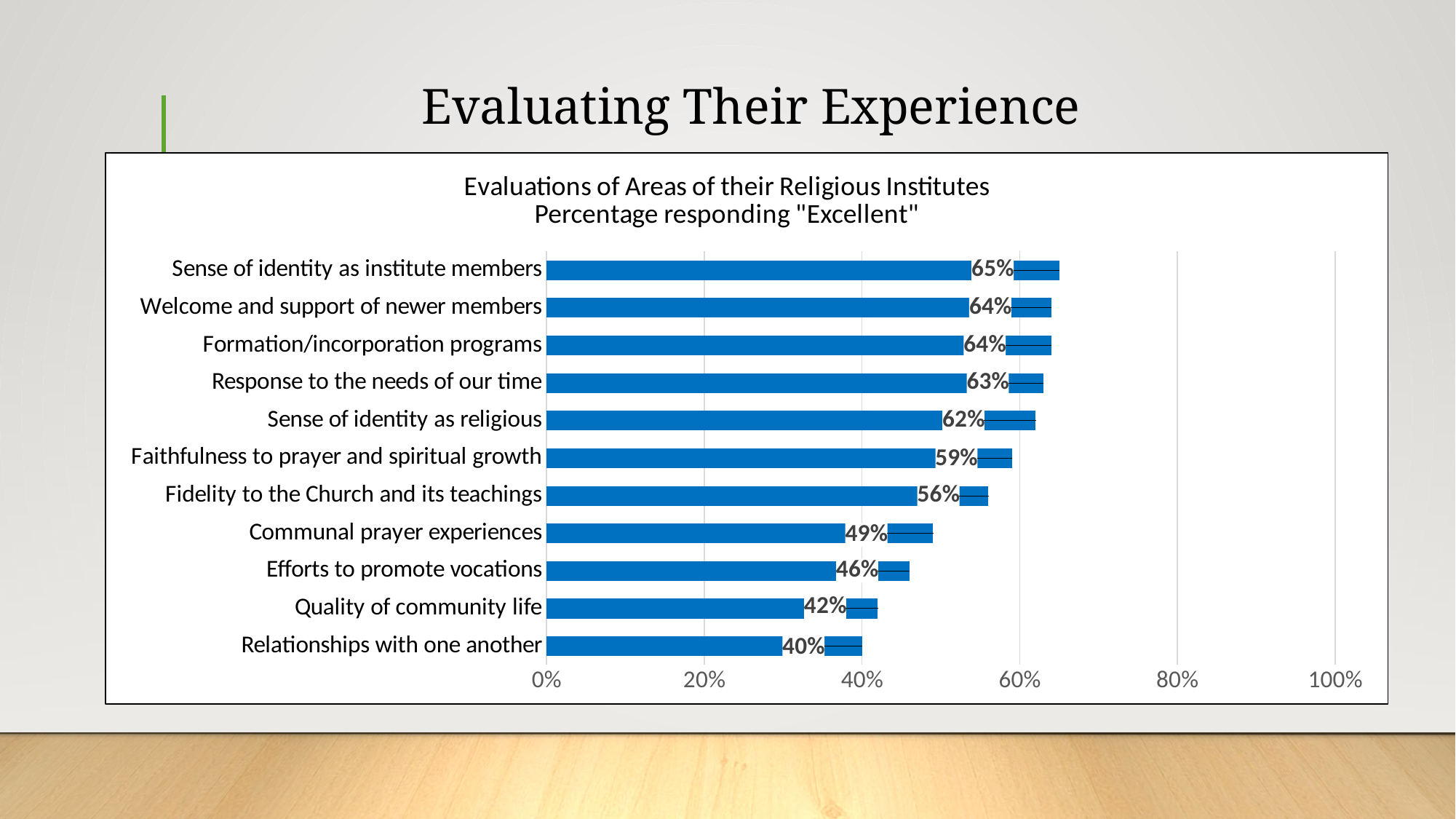
Is the value for Response to the needs of our time greater or less than 80%? less Which area has the lowest percentage responding "Excellent"? Relationships with one another Which area has the highest percentage responding "Excellent"? Sense of identity as institute members What is the value for Fidelity to the Church and its teachings? 56% Which is larger, the value for Quality of community life or the value for Communal prayer experiences? Communal prayer experiences What is the value for Communal prayer experiences? 49% How many areas are shown in the chart? 11 What kind of chart is shown on the slide? bar chart What percentage responded "Excellent" for Relationships with one another? 40% What percentage responded "Excellent" for Sense of identity as institute members? 65% What is the difference between the values for Sense of identity as institute members and Relationships with one another? 25% What is the difference between the values for Faithfulness to prayer and spiritual growth and Efforts to promote vocations? 13%